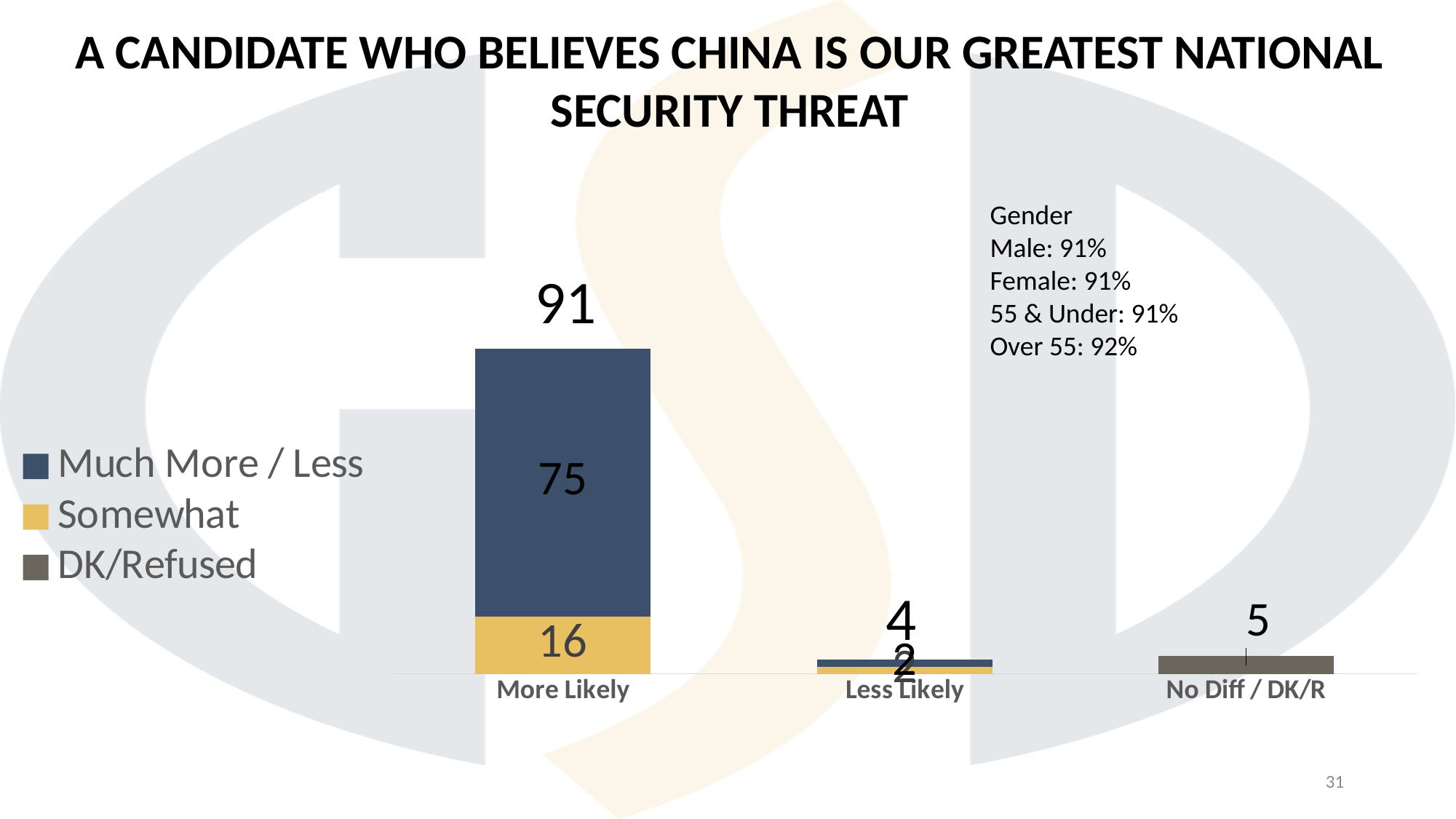
How many series does the legend list? 3 Which category has the highest total? More Likely What is the Much More / Less value for More Likely? 75 What kind of chart is shown? Stacked bar chart What is the Somewhat value for More Likely? 16 What is the total value of the More Likely bar? 91 What is the value for No Diff / DK/R? 5 What is the difference between the Much More / Less and Somewhat values for More Likely? 59 Which category has the lowest total? Less Likely How many categories are shown on the x axis? 3 Which is larger, the total for Less Likely or the value for No Diff / DK/R? No Diff / DK/R What is the total value of the Less Likely bar? 4